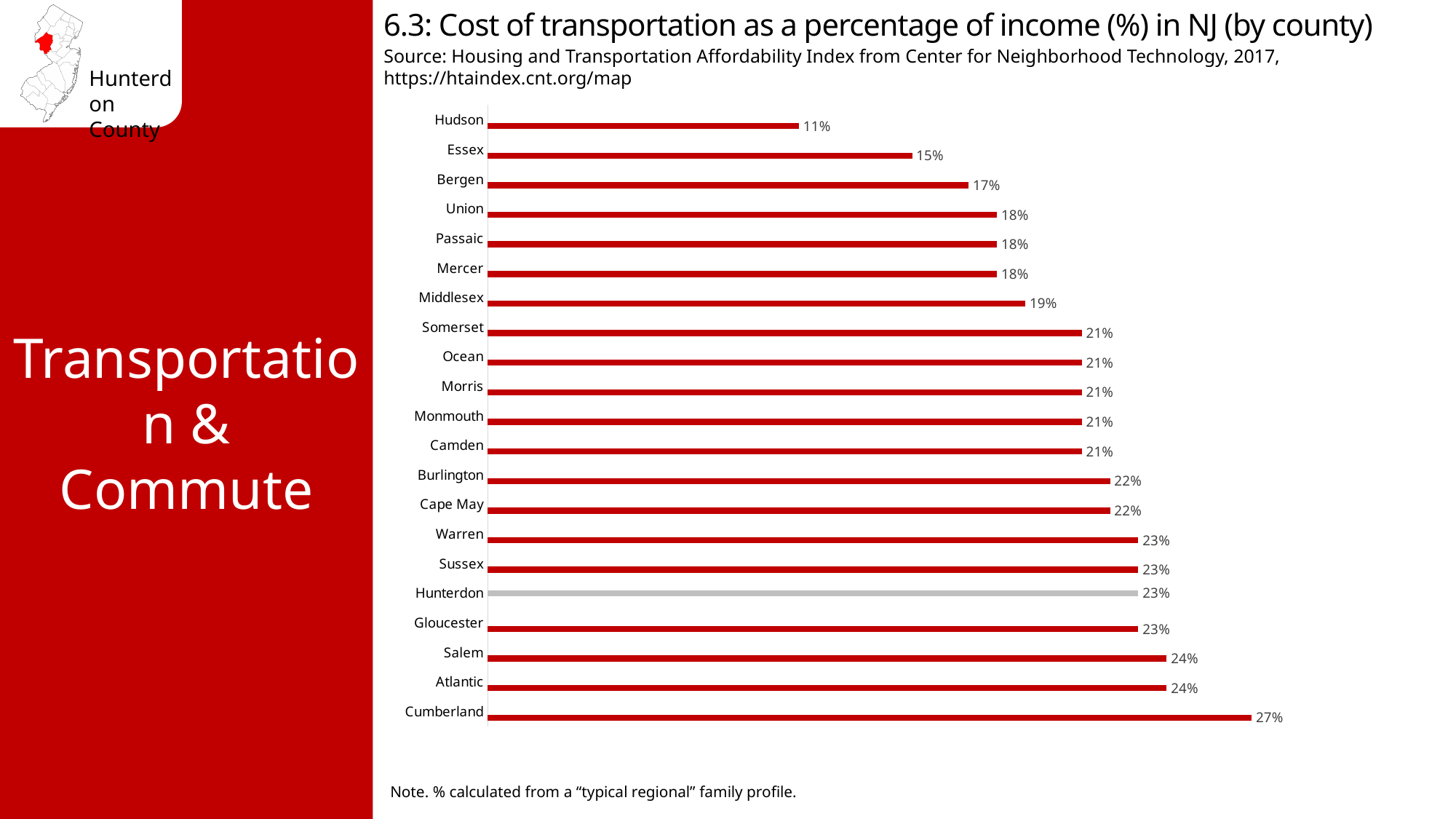
How many counties are shown in the chart? 21 Which county's bar is shown in grey instead of red? Hunterdon Which county has the highest cost of transportation as a percentage of income? Cumberland What kind of chart is shown on the slide? Bar chart What is the difference between the values for Cumberland and Hudson? 16% What is the cost of transportation as a percentage of income for Hudson County? 11% What is the value shown for Middlesex County? 19% Which has a higher value, Bergen or Salem? Salem What is the cost of transportation as a percentage of income for Hunterdon County? 23% Which has a higher value, Middlesex or Somerset? Somerset What is the difference between the values for Hunterdon and Essex? 8% Which county has the lowest cost of transportation as a percentage of income? Hudson